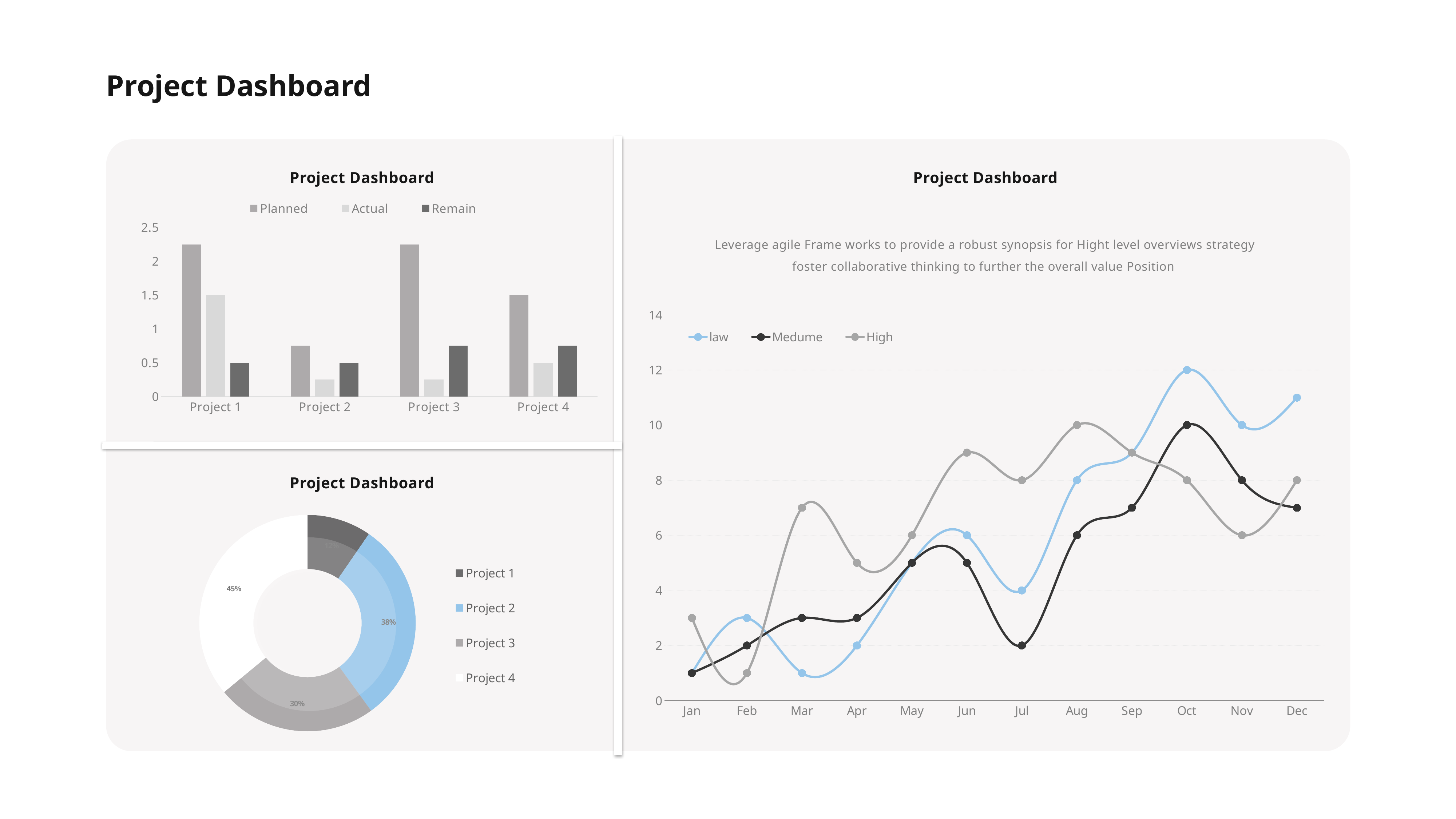
In the line chart on the right, what is the value of the law series in Oct? 12 In the line chart on the right, which series has the higher value in Mar: Medume or High? High What kind of chart is shown at the bottom left of the slide? Doughnut chart In the bar chart at the top left, what is the Planned value for Project 4? 1.5 In the doughnut chart at the bottom left, what share does Project 2 have? 38% In the line chart on the right, what is the value of the High series in Aug? 10 How many series does the legend of the bar chart at the top left list? 3 In the bar chart at the top left, is the Planned value for Project 1 greater or less than 2? greater In the bar chart at the top left, what is the Actual value for Project 1? 1.5 In the doughnut chart at the bottom left, what share does Project 4 have? 45% In the bar chart at the top left, which project has the lowest Planned value? Project 2 In the line chart on the right, how many months are shown on the x axis? 12